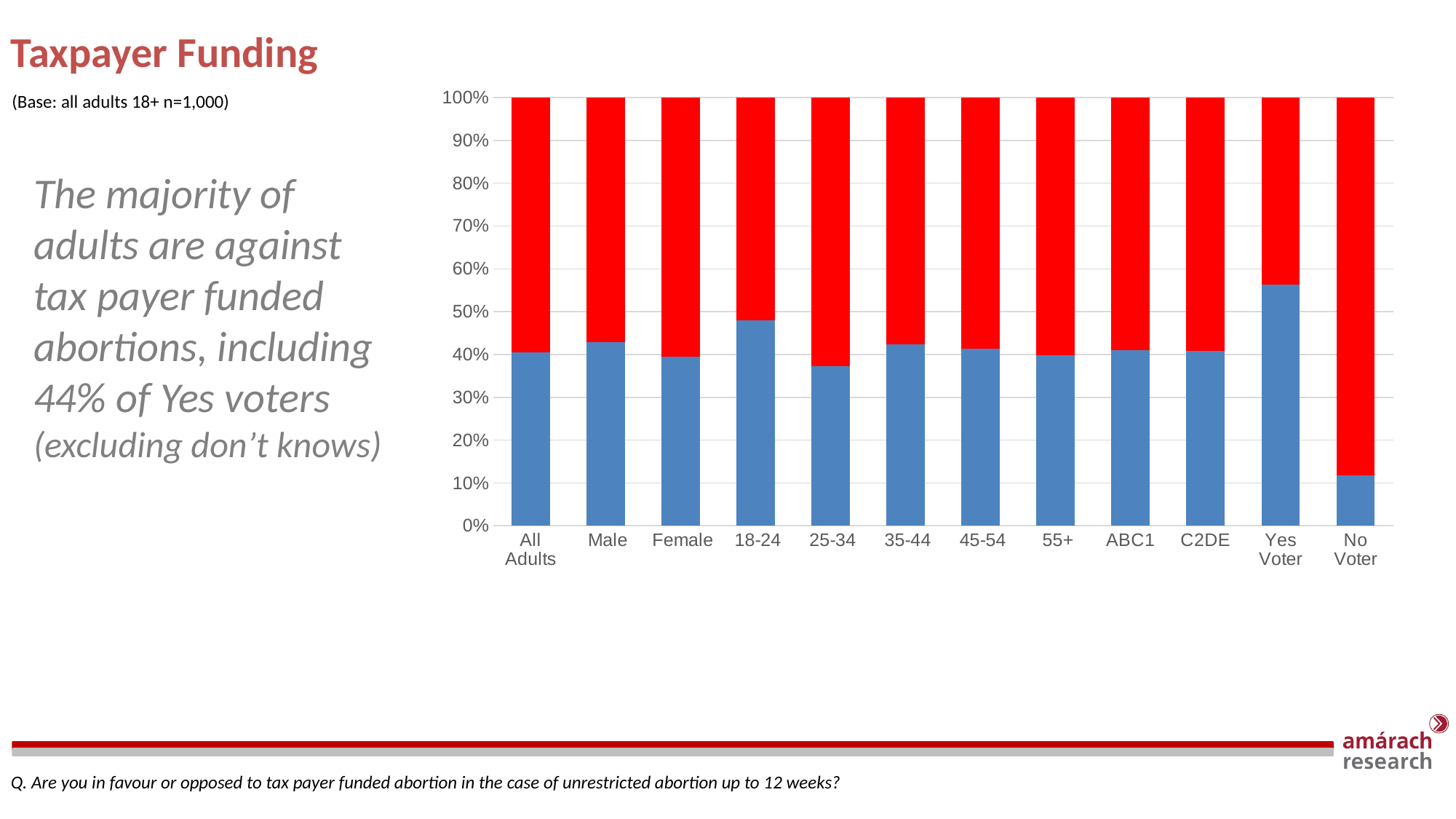
Is the blue segment for Yes Voter greater or less than 50%? greater What kind of chart is shown on the slide? stacked bar chart What is the total height of each stacked bar in the chart? 100% What is the title of the slide containing the chart? Taxpayer Funding Is the blue segment for Male greater or less than 40%? greater Which has the larger blue segment, 18-24 or 25-34? 18-24 Is the blue segment for No Voter greater or less than 20%? less Which has the larger red segment, Yes Voter or No Voter? No Voter How many categories are shown along the x axis of the chart? 12 Which category has the smallest blue segment in the chart? No Voter Which category has the largest blue segment in the chart? Yes Voter